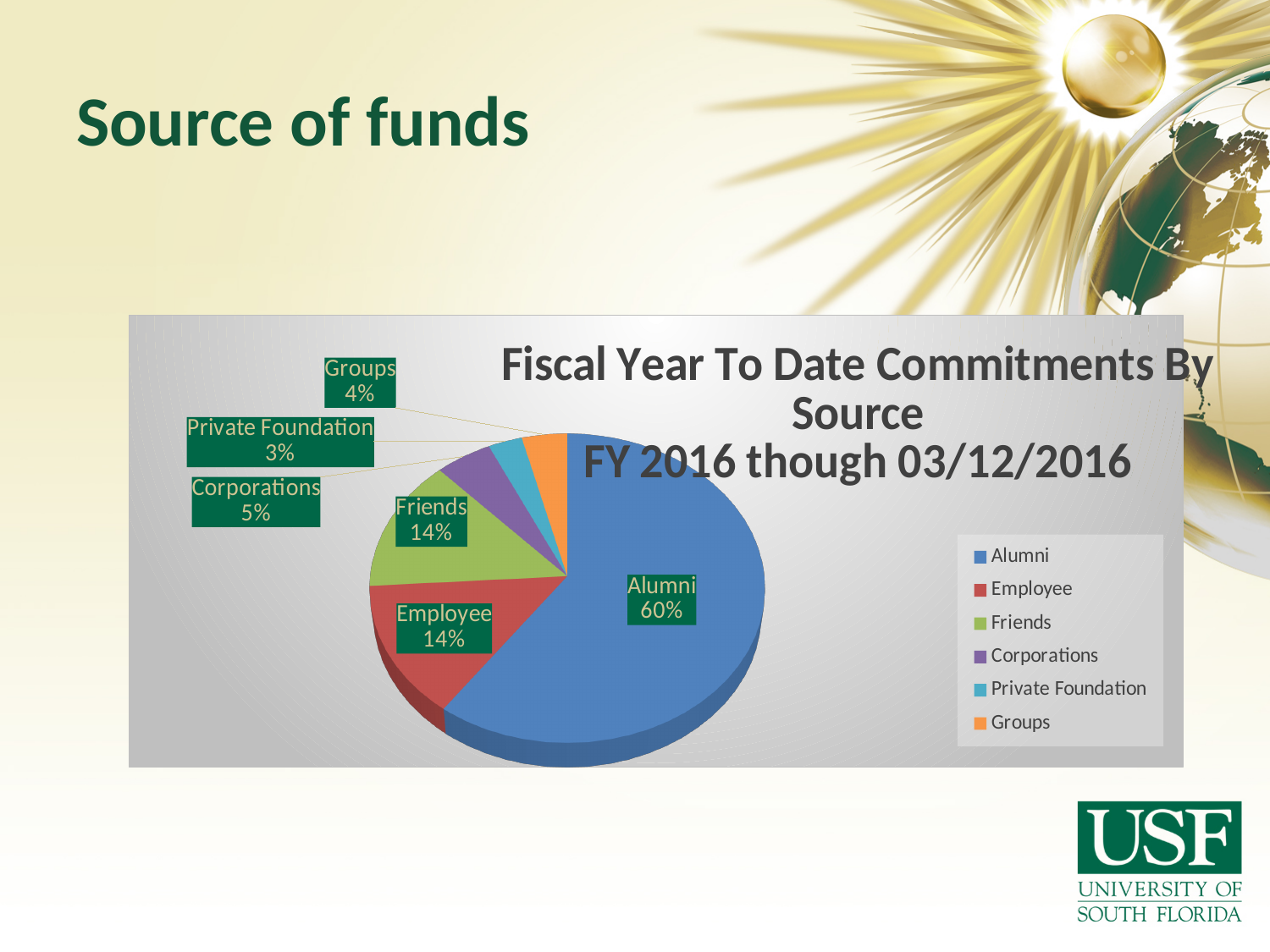
What percentage of commitments comes from Groups? 4% Which source accounts for the smallest share of commitments? Private Foundation What is the title of the chart? Fiscal Year To Date Commitments By Source FY 2016 though 03/12/2016 How many sources are shown in the pie chart? 6 How many percentage points larger is the Alumni share than the Friends share? 46 Which is larger, the share from Corporations or the share from Groups? Corporations Which source accounts for the largest share of commitments? Alumni What type of chart is shown on the slide? Pie chart What percentage of commitments comes from Private Foundations? 3% What share of fiscal year to date commitments comes from Alumni? 60% What percentage of commitments comes from Employees? 14% What percentage of commitments comes from Corporations? 5%